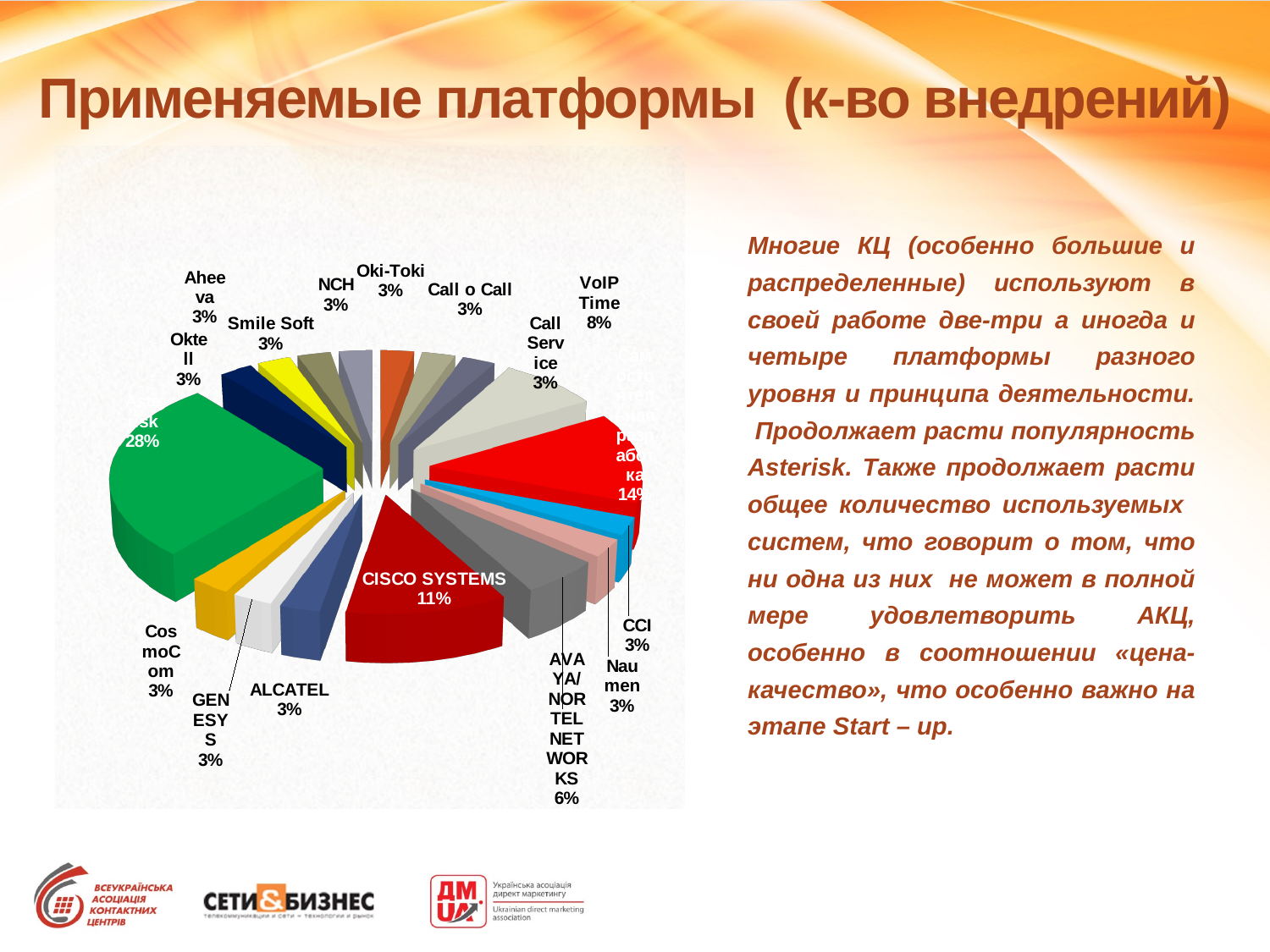
What share of the pie does ALCATEL have? 3% What share of the pie does VoIP Time have? 8% What kind of chart is shown on the slide? pie chart What share of the pie does AVAYA/NORTEL NETWORKS have? 6% What is the title of the slide containing the pie chart? Применяемые платформы (к-во внедрений) Which has the larger share, VoIP Time or AVAYA/NORTEL NETWORKS? VoIP Time What share of the pie does Oki-Toki have? 3% What is the difference in share between VoIP Time and Naumen? 5% What is the difference in share between CISCO SYSTEMS and AVAYA/NORTEL NETWORKS? 5% What share of the pie does CISCO SYSTEMS have? 11% What is the share of the largest slice in the pie? 28% Which has the larger share, CISCO SYSTEMS or VoIP Time? CISCO SYSTEMS